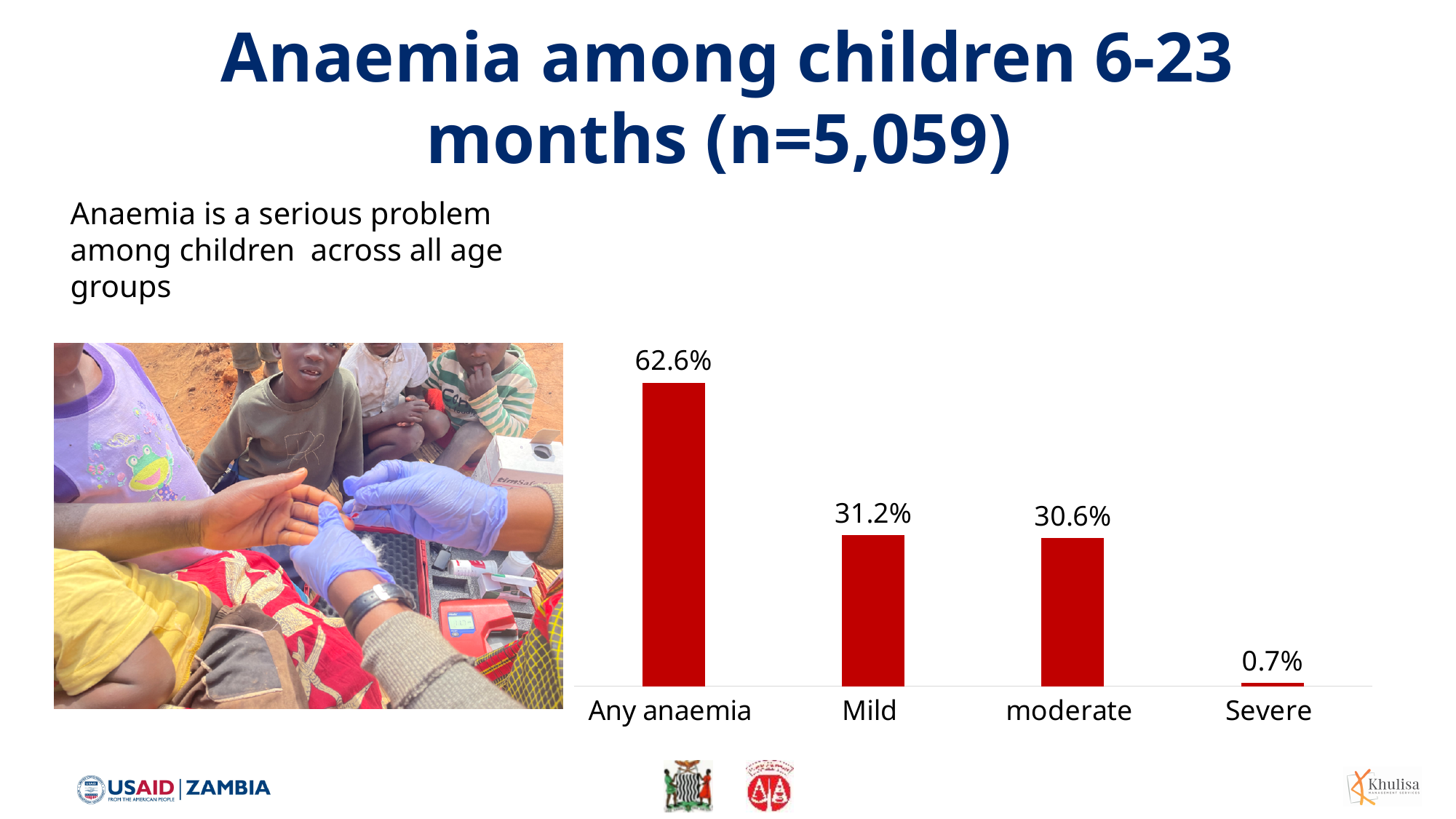
What is the value for Any anaemia? 62.6% What is the value for moderate? 30.6% What is the difference between the values for Mild and moderate? 0.6% Which category has the highest value? Any anaemia What is the difference between the values for Any anaemia and Mild? 31.4% What is the value for Severe? 0.7% What is the value for Mild? 31.2% Which is larger, the value for Any anaemia or the value for Severe? Any anaemia What colour are the bars in the chart? Red Which category has the lowest value? Severe How many categories are shown on the chart? 4 What kind of chart is shown on the slide? Bar chart